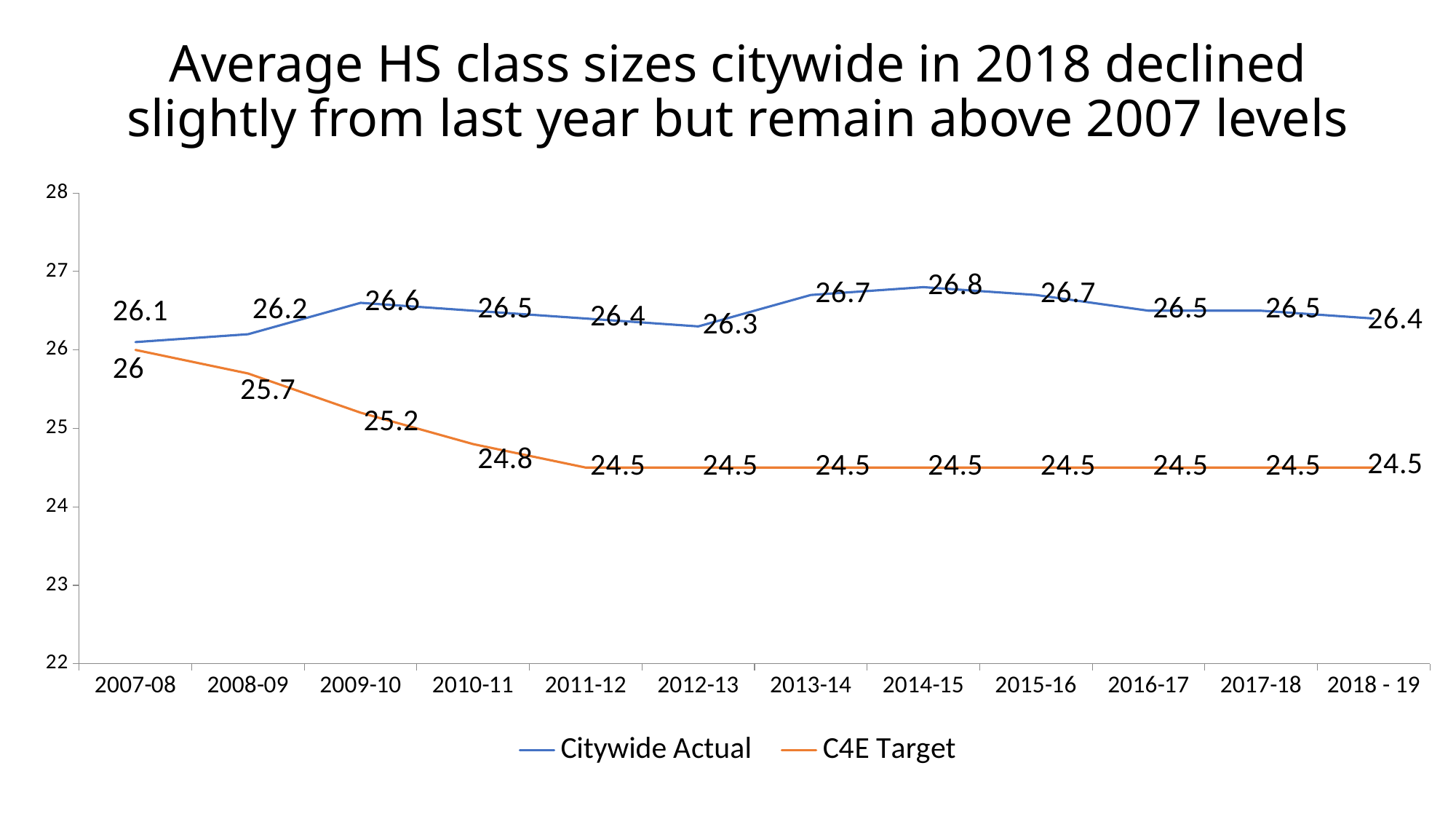
In which year is the Citywide Actual value lowest? 2007-08 What is the C4E Target value for 2009-10? 25.2 Does the C4E Target series rise or fall from 2007-08 to 2011-12? Fall What is the difference between the Citywide Actual and C4E Target values in 2018 - 19? 1.9 What kind of chart is shown on the slide? Line chart In which year is the Citywide Actual value highest? 2014-15 Which is larger in 2007-08, the Citywide Actual value or the C4E Target value? Citywide Actual What is the Citywide Actual value for 2014-15? 26.8 How many years are shown on the x axis? 12 What colour is the line for the C4E Target series? Orange What is the Citywide Actual value for 2018 - 19? 26.4 How many series does the legend list? 2